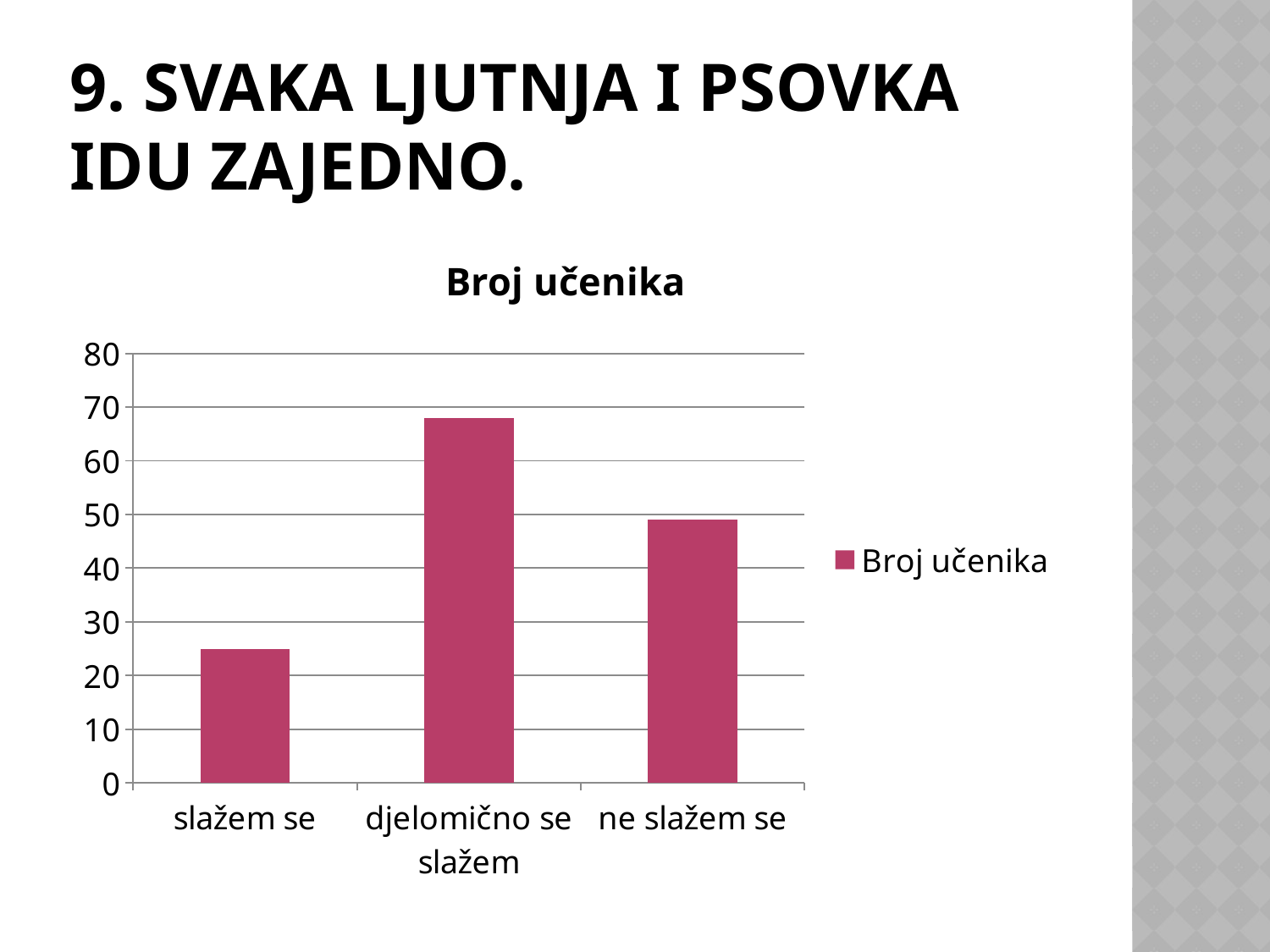
Is the value for 'slažem se' greater or less than 30? less What is the title of the chart? Broj učenika Which is larger, the value for 'ne slažem se' or the value for 'slažem se'? ne slažem se Which category has the lowest value? slažem se How many series does the legend list? 1 Which is larger, the value for 'djelomično se slažem' or the value for 'ne slažem se'? djelomično se slažem Is the value for 'ne slažem se' greater or less than 40? greater What kind of chart is shown on the slide? bar chart Which category has the highest value? djelomično se slažem How many categories are shown on the x axis of the chart? 3 Is the value for 'djelomično se slažem' greater or less than 70? less